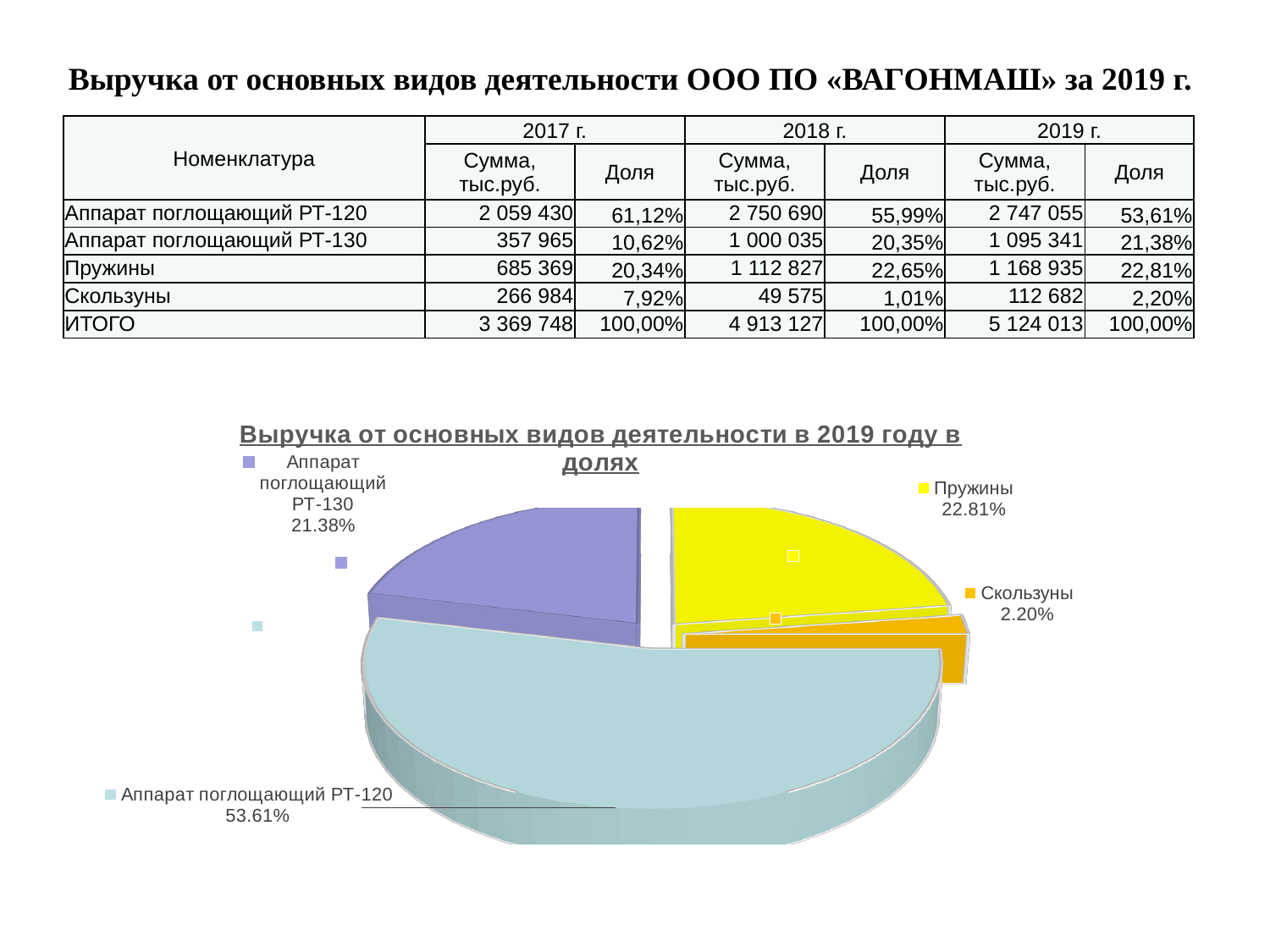
What share of the pie does Скользуны have? 2.20% What share of the pie does Аппарат поглощающий РТ-130 have? 21.38% What share of the pie does Аппарат поглощающий РТ-120 have? 53.61% What kind of chart is shown on the slide? pie chart What is the difference in percentage points between the Аппарат поглощающий РТ-120 slice and the Пружины slice? 30.80% What is the chart's title? Выручка от основных видов деятельности в 2019 году в долях Which slice of the pie is the largest? Аппарат поглощающий РТ-120 What colour is the Пружины slice of the pie? yellow How many slices does the pie chart have? 4 Which slice is larger, Пружины or Аппарат поглощающий РТ-130? Пружины Which slice of the pie is the smallest? Скользуны